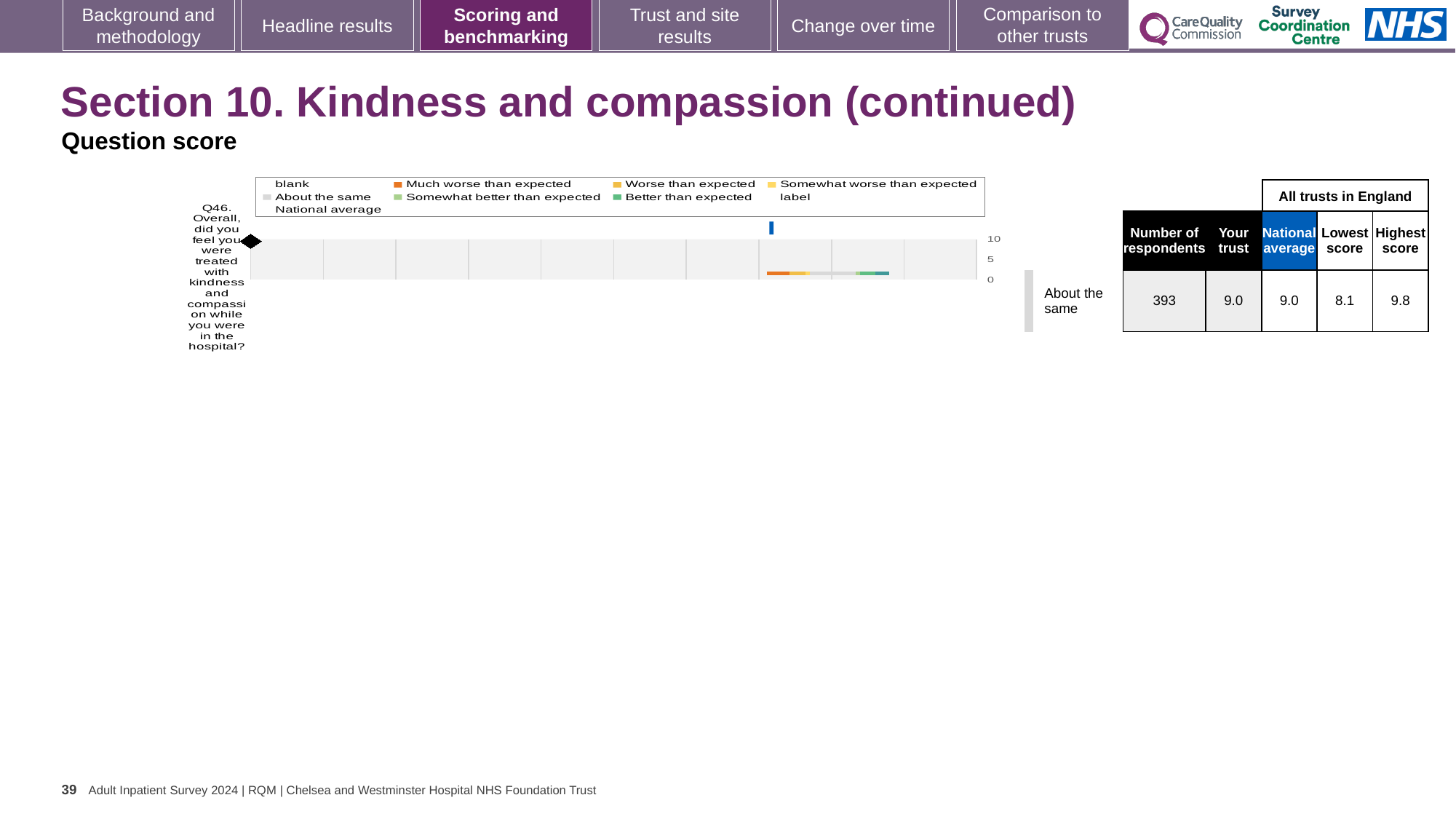
What is the highest tick value shown on the chart's score axis? 10 How is the trust's result for Q46 categorised relative to expectations? About the same What kind of chart is shown on the slide? bar chart What is the lowest score among all trusts in England for Q46? 8.1 Which question number is plotted on the chart? Q46 What colour represents 'Much worse than expected' in the legend? orange How many respondents answered Q46? 393 What is the highest score among all trusts in England for Q46? 9.8 What is the 'Your trust' score for Q46? 9.0 What is the difference between the highest score and the lowest score for Q46? 1.7 What is the national average score for Q46? 9.0 How many survey questions are plotted on the chart? 1